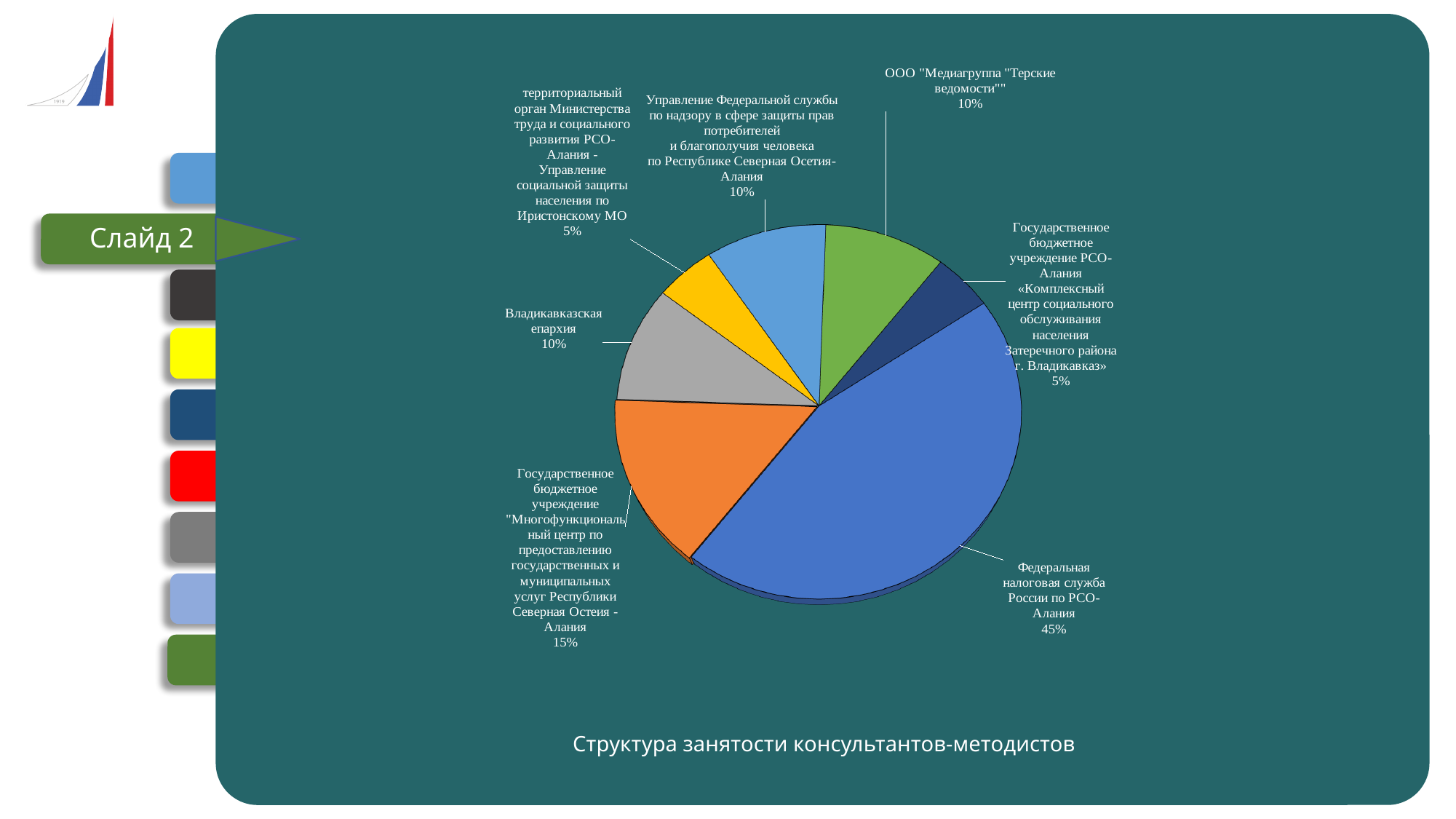
What percentage is shown for "ООО "Медиагруппа "Терские ведомости"""? 10% What share of the pie is "Владикавказская епархия"? 10% What kind of chart is shown on the slide? Pie chart What share of the pie is "Федеральная налоговая служба России по РСО-Алания"? 45% What colour is the slice for "Федеральная налоговая служба России по РСО-Алания"? Blue What is the title of the chart? Структура занятости консультантов-методистов Which category has the largest share of the pie? Федеральная налоговая служба России по РСО-Алания How many slices does the pie chart have? 7 What percentage is shown for the "Многофункциональный центр" (Государственное бюджетное учреждение) slice? 15% What is the difference in percentage points between "Федеральная налоговая служба России по РСО-Алания" and the "Многофункциональный центр" slice? 30 Which is larger: the share for "Владикавказская епархия" or the share for "Комплексный центр социального обслуживания населения Затеречного района г. Владикавказ"? Владикавказская епархия What percentage is shown for "Управление социальной защиты населения по Иристонскому МО"? 5%